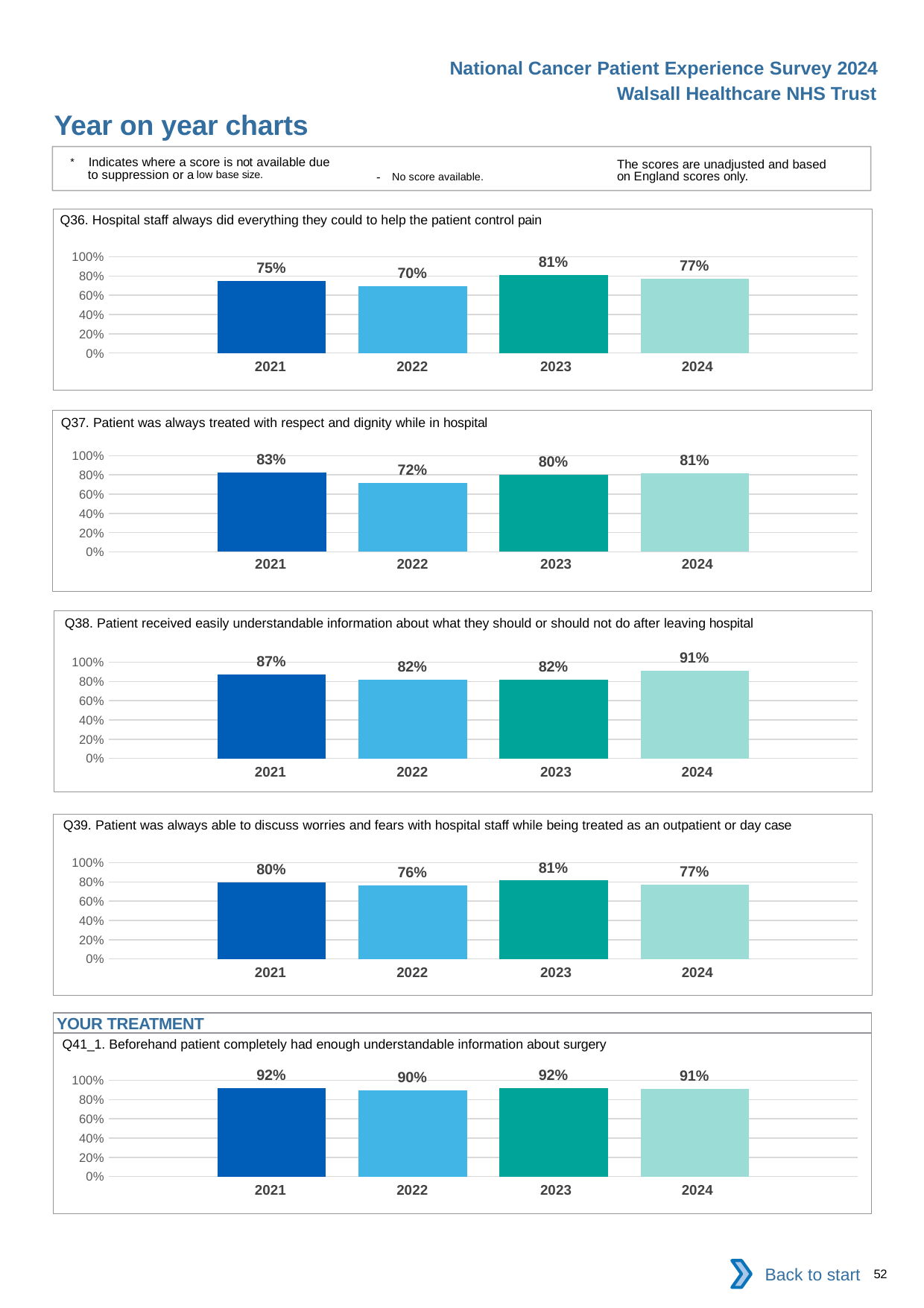
In the Q39 chart, which is larger, the value for 2021 or the value for 2022? 2021 In the Q38 chart, which year has the highest value? 2024 In the Q38 chart, what is the difference between the 2024 value and the 2021 value? 4% What is the section heading shown above the Q41_1 chart? YOUR TREATMENT In the Q37 chart, which year has the lowest value? 2022 In the Q37 chart, what is the value for 2024? 81% How many years are shown in the Q36 chart? 4 What kind of chart is the Q37 chart? bar chart In the Q41_1 chart, what is the value for 2022? 90% In the Q39 chart, is the value for 2023 greater or less than 80%? greater In the Q36 chart, what is the value for 2023? 81% In the Q36 chart, what is the difference between the 2021 value and the 2022 value? 5%